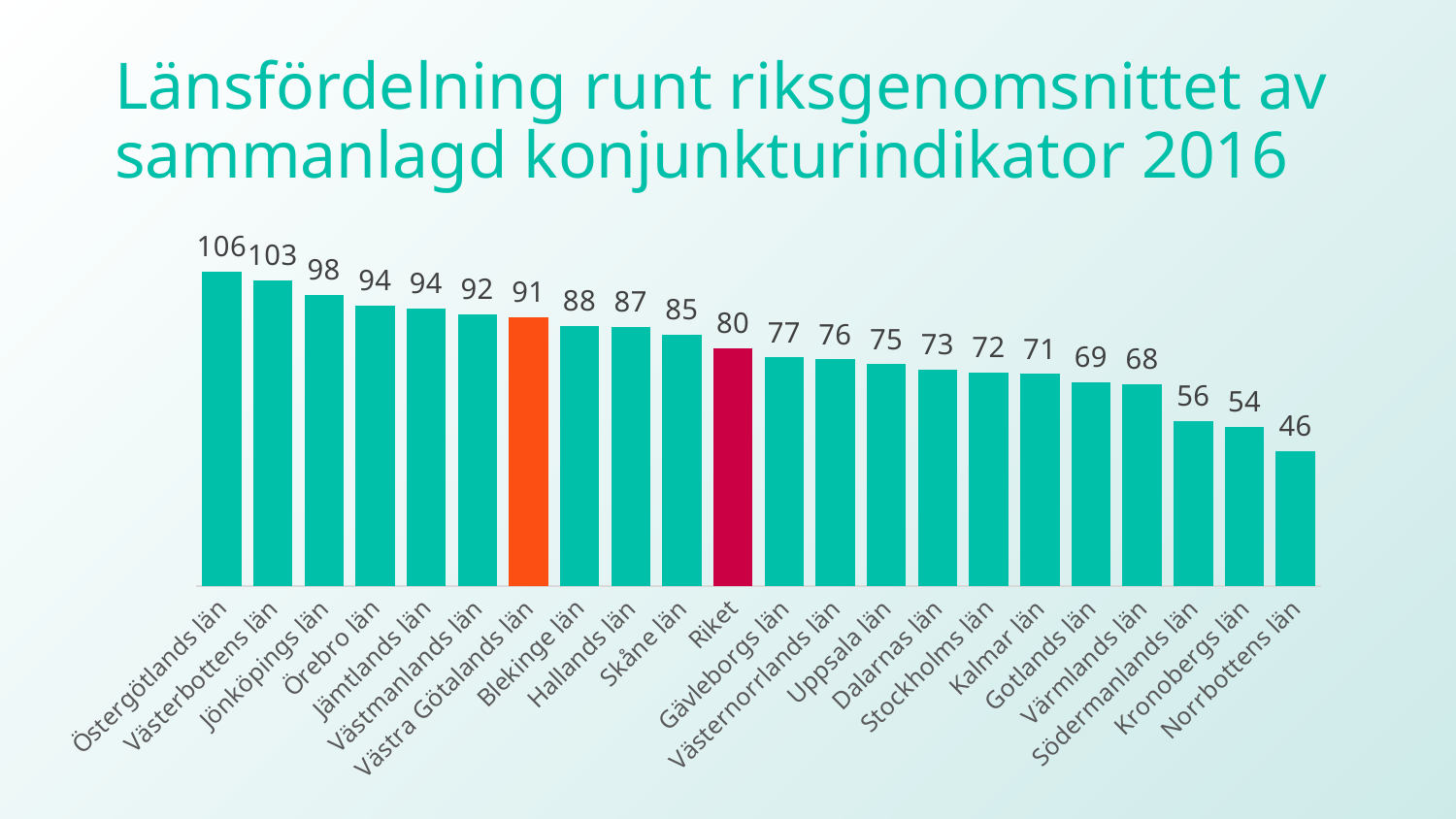
Which is larger, the value for Skåne län or the value for Gävleborgs län? Skåne län What is the value for Riket? 80 What kind of chart is shown on the slide? Bar chart Which category has the lowest value? Norrbottens län Do the values rise or fall from left to right along the x axis? Fall Which category has the highest value? Östergötlands län What is the value for Västra Götalands län? 91 How many bars are shown in the chart? 22 What is the difference between the values for Västra Götalands län and Riket? 11 What is the value for Stockholms län? 72 What is the difference between the values for Östergötlands län and Norrbottens län? 60 Which bar is coloured dark red/magenta? Riket